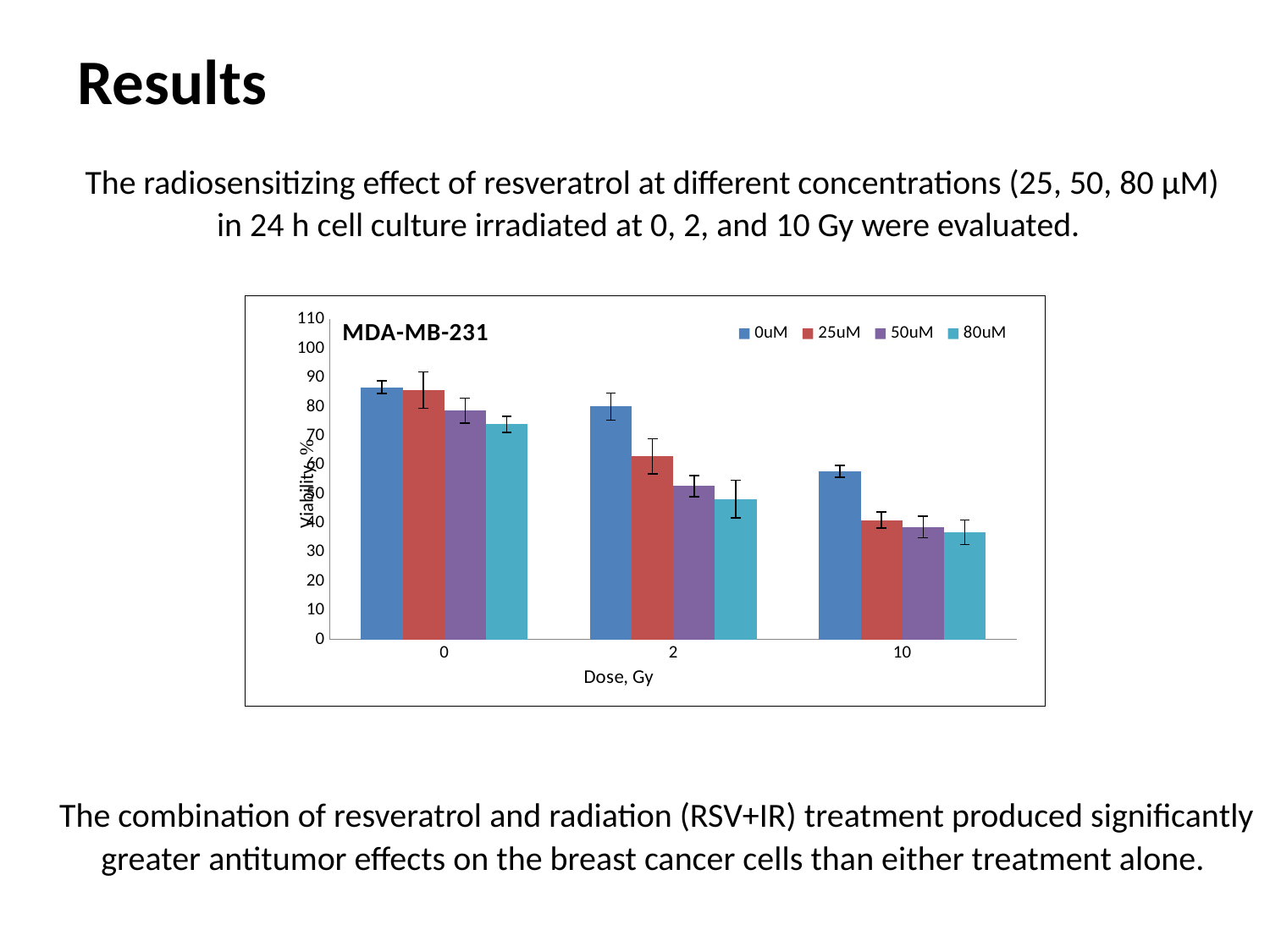
How many series does the chart legend list? 4 Is the viability for 0uM at 0 Gy greater or less than 80? greater Is the viability for 0uM at 10 Gy greater or less than 50? greater Which concentration has the highest viability at 10 Gy? 0uM What kind of chart is shown on the slide? bar chart How many dose categories are shown on the x axis? 3 What is the label of the x axis? Dose, Gy At 2 Gy, which is larger: the viability for 0uM or for 25uM? 0uM Is the viability for 80uM at 0 Gy greater or less than 80? less What is the title of the chart? MDA-MB-231 Does the viability for 0uM rise or fall as the dose increases from 0 to 10 Gy? fall